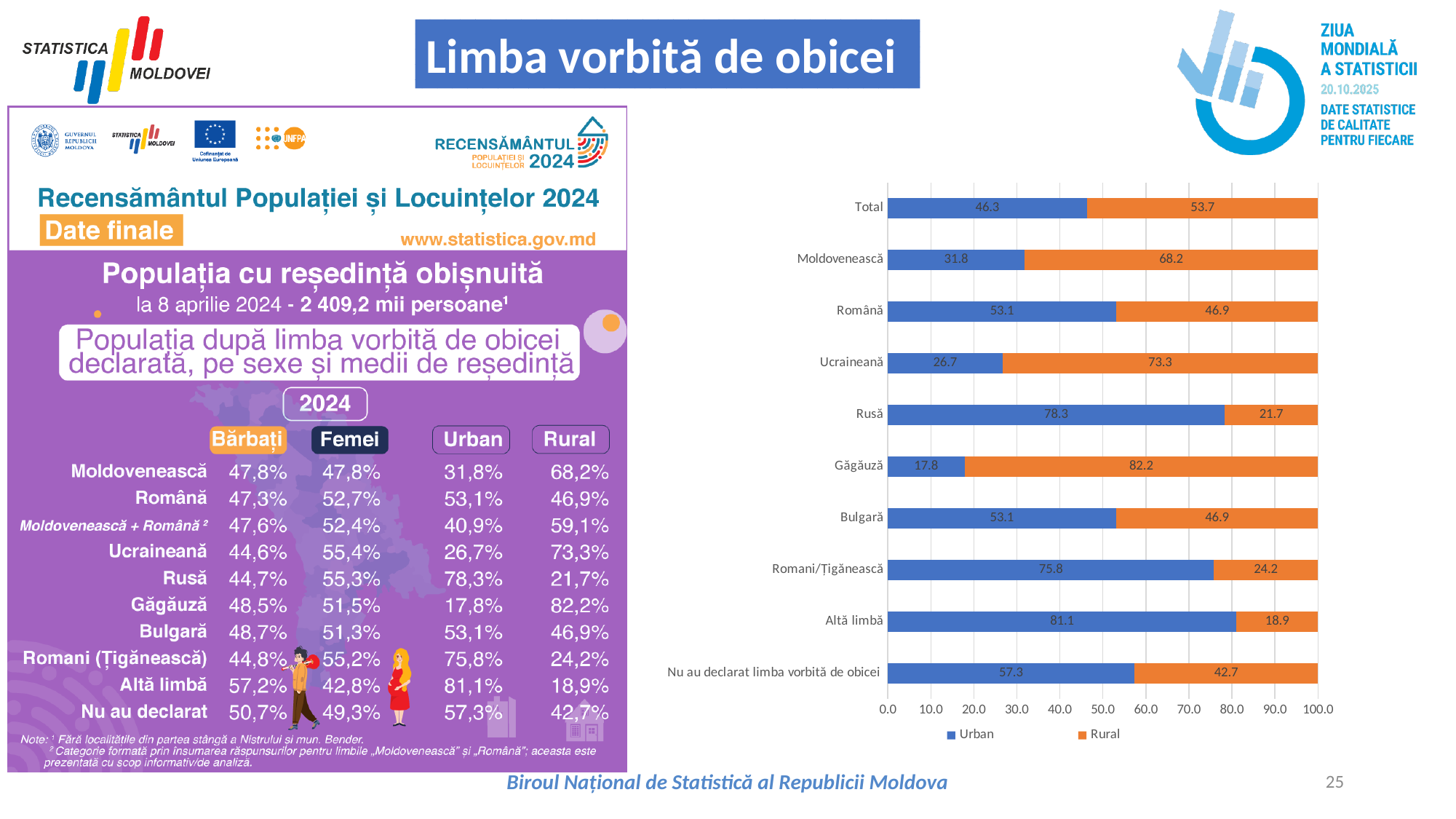
What is the Rural value for Moldovenească? 68.2 How many series does the legend list? 2 What kind of chart is shown on the slide? Stacked bar chart Which category has the highest Urban value? Altă limbă What is the total of the stacked bar for Nu au declarat limba vorbită de obicei? 100.0 Which is larger, the Urban value for Romani/Țigănească or the Urban value for Bulgară? Romani/Țigănească What is the Urban value for Rusă? 78.3 What is the difference between the Rural and Urban values for Ucraineană? 46.6 How many categories are shown on the chart? 10 Which category has the highest Rural value? Găgăuză Which category has the lowest Urban value? Găgăuză What is the Urban value for Total? 46.3